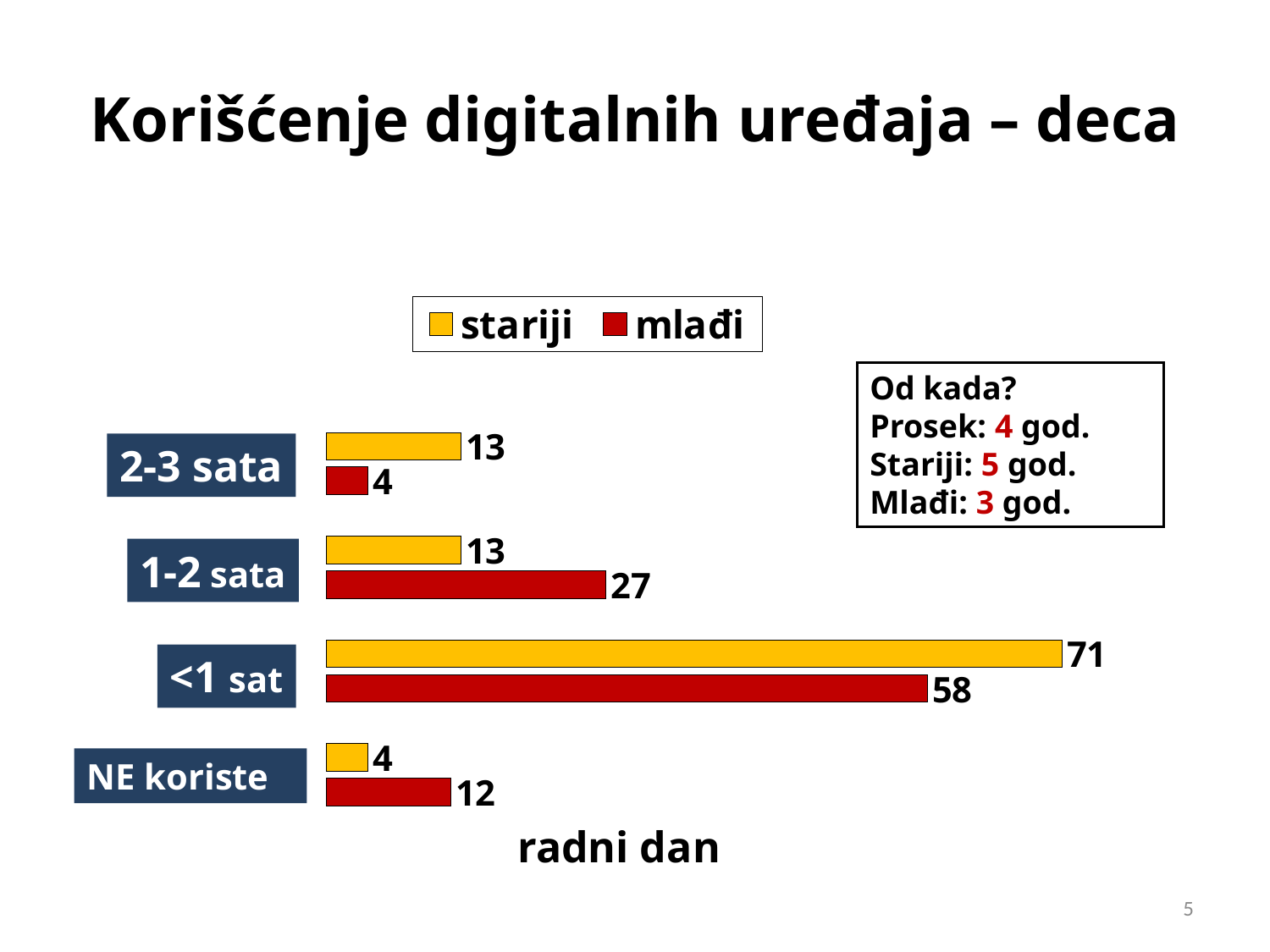
Which category has the lowest value for 'stariji'? NE koriste What is the difference between the 'stariji' and 'mlađi' values in the '<1 sat' category? 13 How many series does the legend list? 2 In the '2-3 sata' category, which series has the larger value, 'stariji' or 'mlađi'? stariji What is the value for 'mlađi' in the 'NE koriste' category? 12 What is the value for 'mlađi' in the '1-2 sata' category? 27 How many categories are shown in the chart? 4 What colour represents the 'mlađi' series in the chart? red What is the difference between the 'mlađi' and 'stariji' values in the '1-2 sata' category? 14 What is the value for 'stariji' in the '<1 sat' category? 71 Which category has the highest value for 'mlađi'? <1 sat What kind of chart is shown on the slide? bar chart